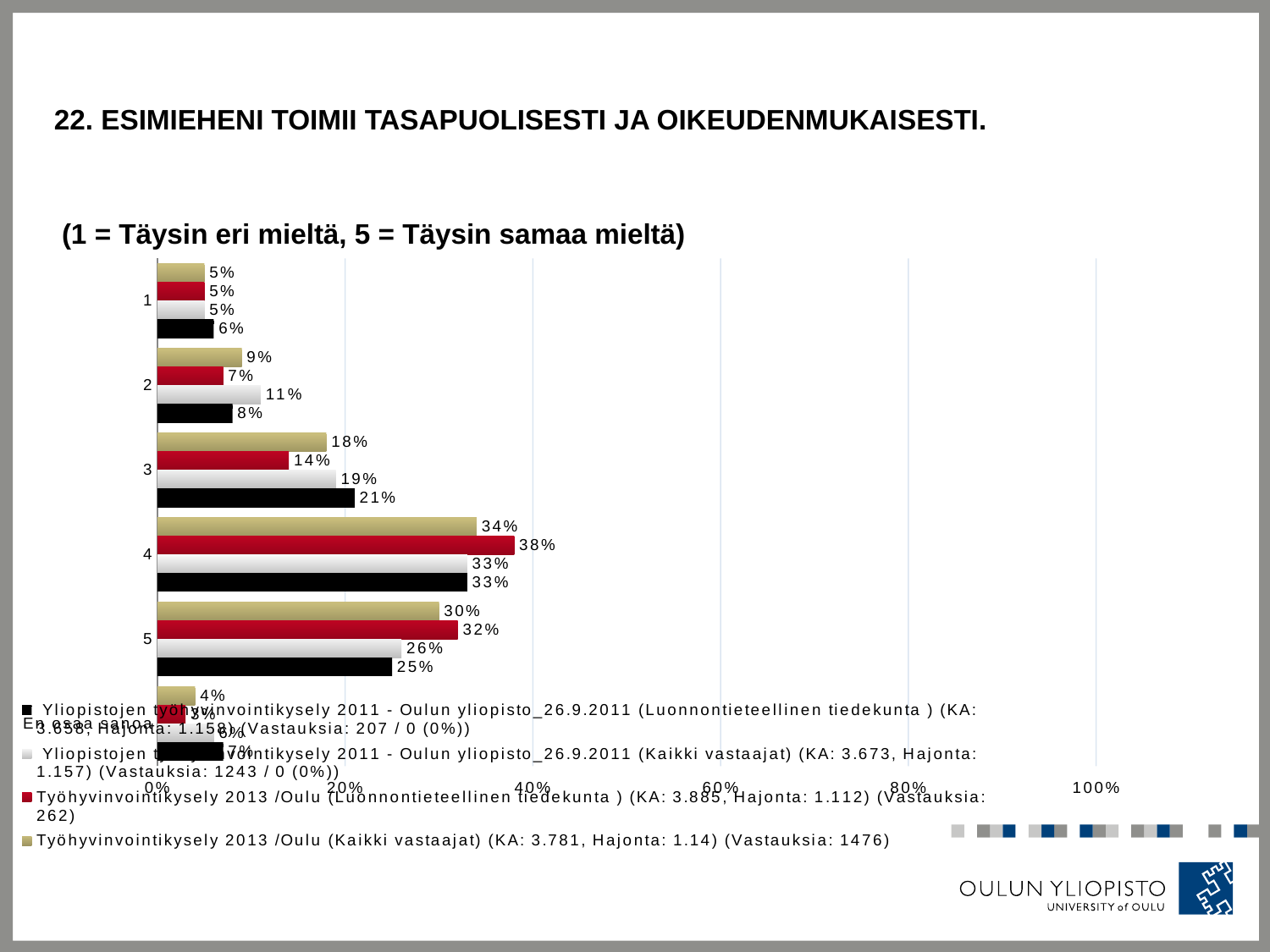
Which rating category has the highest value in the series Työhyvinvointikysely 2013 /Oulu (Kaikki vastaajat)? 4 For category 5, which series has the larger value: Työhyvinvointikysely 2013 /Oulu (Luonnontieteellinen tiedekunta) or Yliopistojen työhyvinvointikysely 2011 - Oulun yliopisto (Luonnontieteellinen tiedekunta)? Työhyvinvointikysely 2013 /Oulu (Luonnontieteellinen tiedekunta) What is the value for category 2 in the series Yliopistojen työhyvinvointikysely 2011 - Oulun yliopisto (Kaikki vastaajat)? 11% What kind of chart is shown on the slide? bar chart Is the value for category 4 in the series Työhyvinvointikysely 2013 /Oulu (Luonnontieteellinen tiedekunta) greater or less than 20%? greater What is the value for category 5 in the series Työhyvinvointikysely 2013 /Oulu (Kaikki vastaajat)? 30% What is the value for category 4 in the series Työhyvinvointikysely 2013 /Oulu (Luonnontieteellinen tiedekunta)? 38% How many series does the legend list? 4 What is the value for category 3 in the series Yliopistojen työhyvinvointikysely 2011 - Oulun yliopisto (Luonnontieteellinen tiedekunta)? 21% What is the title of the slide containing the chart? 22. ESIMIEHENI TOIMII TASAPUOLISESTI JA OIKEUDENMUKAISESTI. Which rating category (1 to 5) has the lowest value in the series Työhyvinvointikysely 2013 /Oulu (Luonnontieteellinen tiedekunta)? 1 What is the difference between the values for category 4 and category 5 in the series Työhyvinvointikysely 2013 /Oulu (Luonnontieteellinen tiedekunta)? 6%